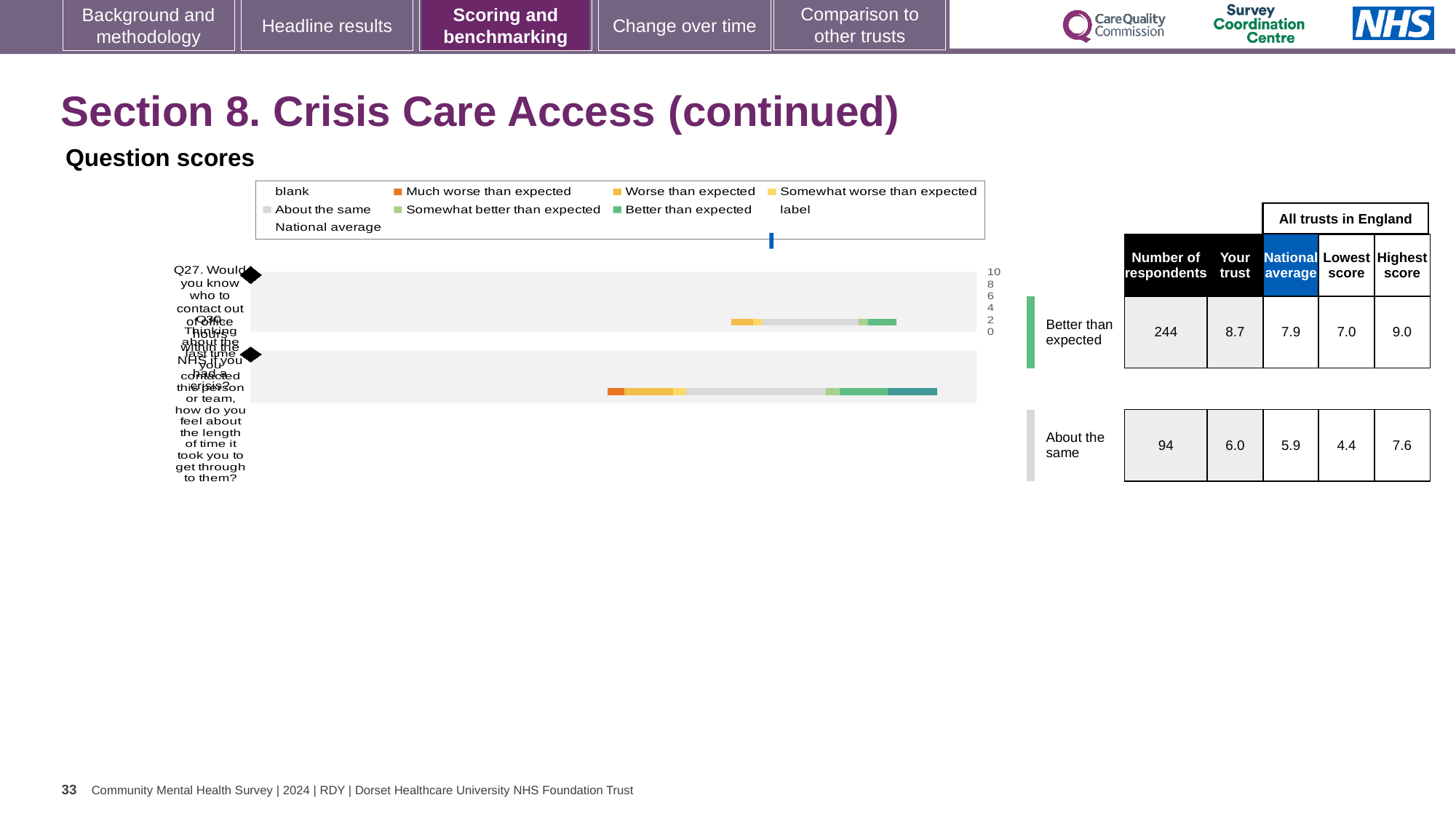
Which legend entry is shown in orange in the question scores chart? Much worse than expected What is the national average score for Q27? 7.9 Which question has the higher 'Your trust' score, Q27 or Q30? Q27 What is the 'Your trust' score for Q30 (how do you feel about the length of time it took you to get through to them)? 6.0 What benchmark category is Q30 placed in? About the same What is the highest score among all trusts in England for Q30? 7.6 What is the lowest score among all trusts in England for Q27? 7.0 What is the 'Your trust' score for Q27 (Would you know who to contact out of office hours within the NHS if you had a crisis?)? 8.7 What is the difference between the trust's score and the national average for Q27? 0.8 How many respondents answered Q27? 244 What kind of chart is used to show the question scores on this slide? Bar chart How many questions are plotted in the question scores chart? 2